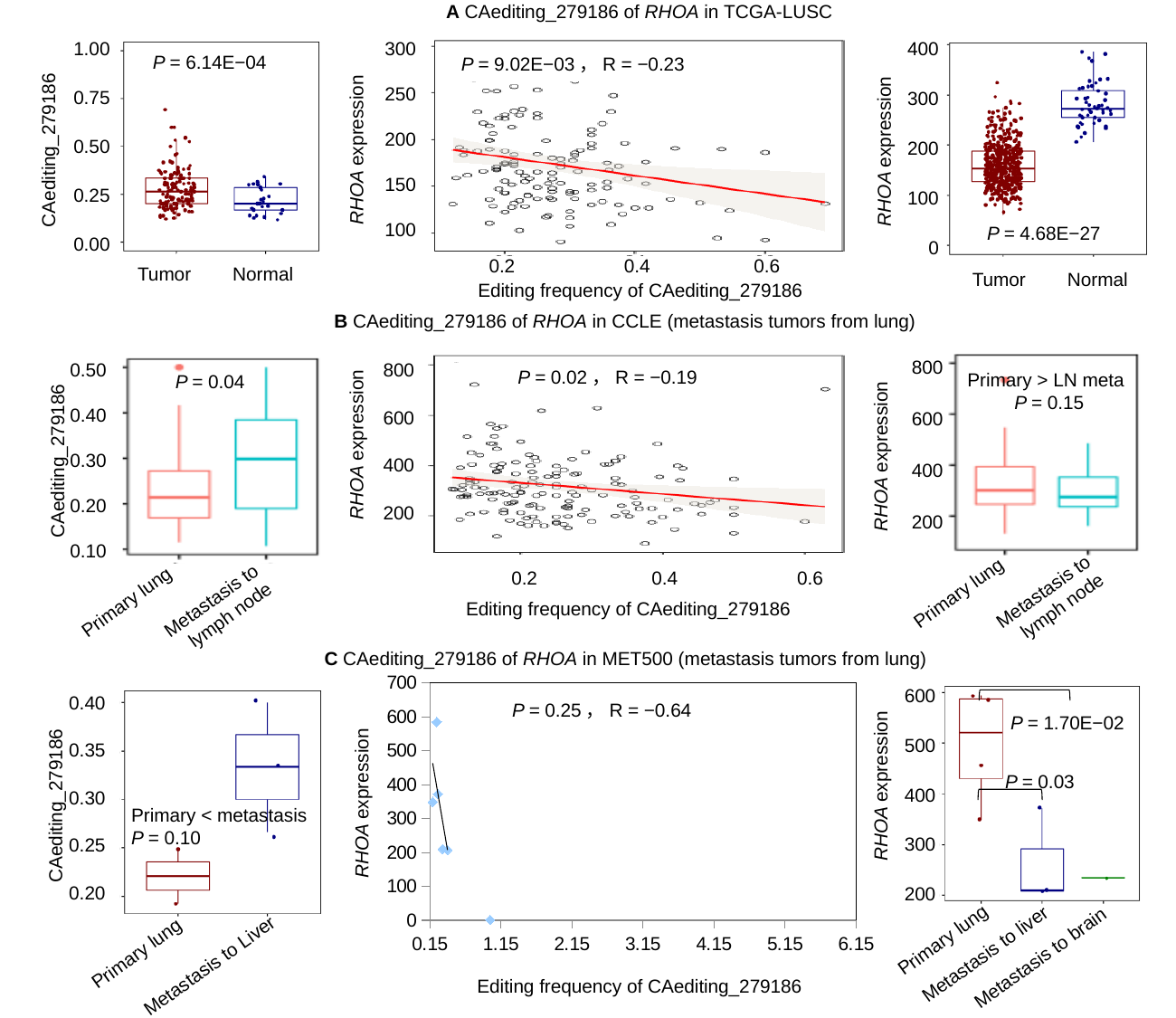
In panel B, on the left box plot, is the median CAediting_279186 for Metastasis to lymph node greater or less than 0.25? greater In panel C, what R value is printed on the middle scatter plot? -0.64 In panel A, what correlation coefficient R is printed on the middle scatter plot of RHOA expression versus editing frequency? -0.23 In panel B, what P value is shown on the left box plot of CAediting_279186 for Primary lung versus Metastasis to lymph node? 0.04 In panel A, what is the P value printed on the right box plot of RHOA expression in Tumor versus Normal? 4.68E-27 In panel A, on the right box plot of RHOA expression, which group has the higher median, Tumor or Normal? Normal In panel C, what P value is shown between Primary lung and Metastasis to liver on the right box plot of RHOA expression? 0.03 In panel A, does the fitted red line on the middle scatter plot rise or fall as editing frequency increases? fall In panel C, how many groups are shown on the right box plot of RHOA expression? 3 In panel C, on the right box plot of RHOA expression, which group has the higher median, Primary lung or Metastasis to liver? Primary lung In panel A, what is the P value shown on the left box plot comparing Tumor and Normal CAediting_279186? 6.14E-04 In panel A, on the right box plot of RHOA expression, is the median for Normal greater or less than 200? greater